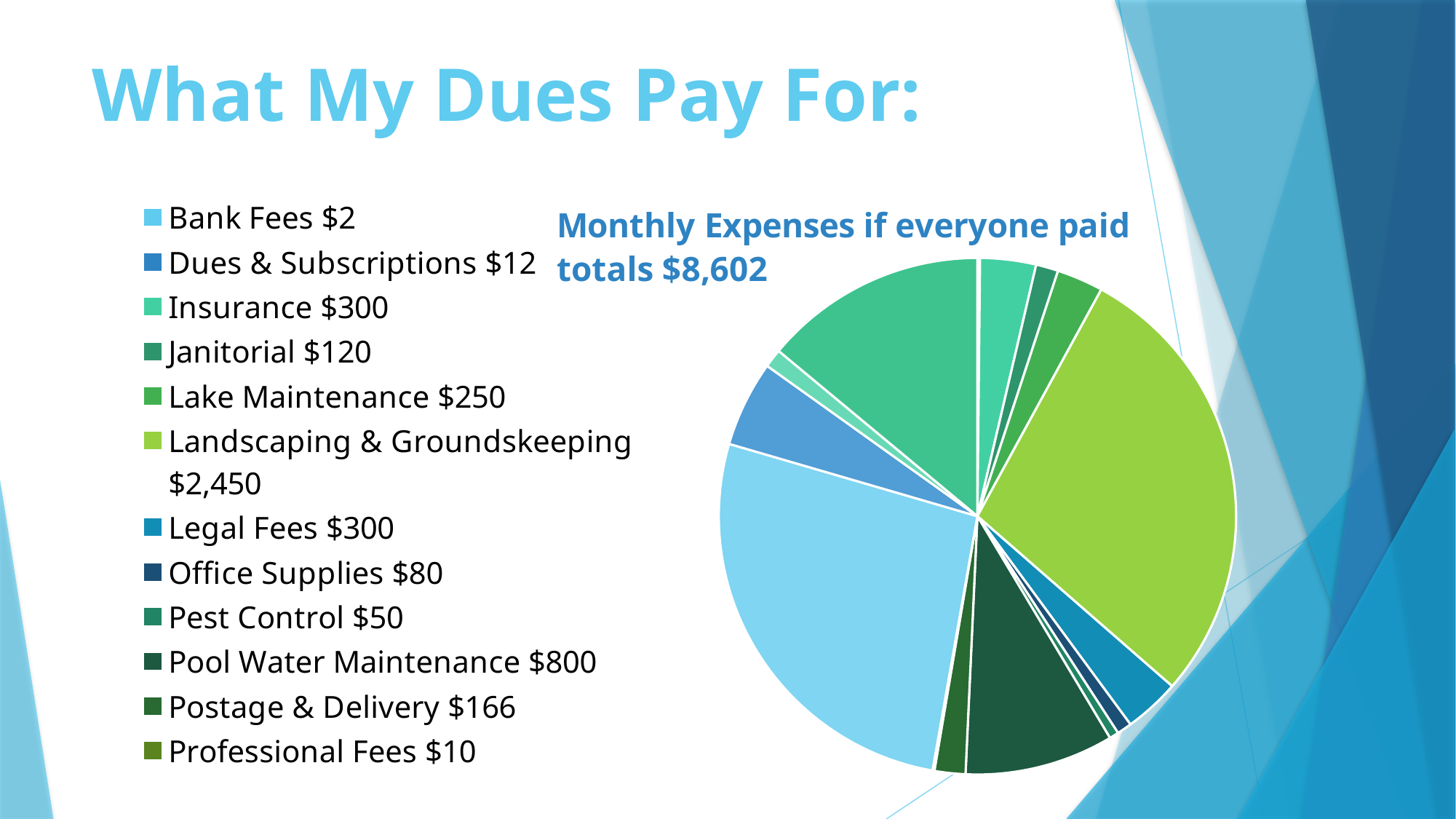
What is the value shown for Landscaping & Groundskeeping in the legend? $2,450 What is the value shown for Pool Water Maintenance? $800 What is the title of the chart? Monthly Expenses if everyone paid totals $8,602 What is the value shown for Postage & Delivery? $166 What is the difference between the Pool Water Maintenance value and the Pest Control value? $750 What is the difference between the Legal Fees value and the Office Supplies value? $220 Which is larger, the value for Janitorial or the value for Lake Maintenance? Lake Maintenance Of the categories listed in the legend, which has the lowest value? Bank Fees What kind of chart is shown on the slide? Pie chart Of the categories listed in the legend, which has the highest value? Landscaping & Groundskeeping What is the value shown for Janitorial? $120 How many categories are listed in the chart's legend? 12